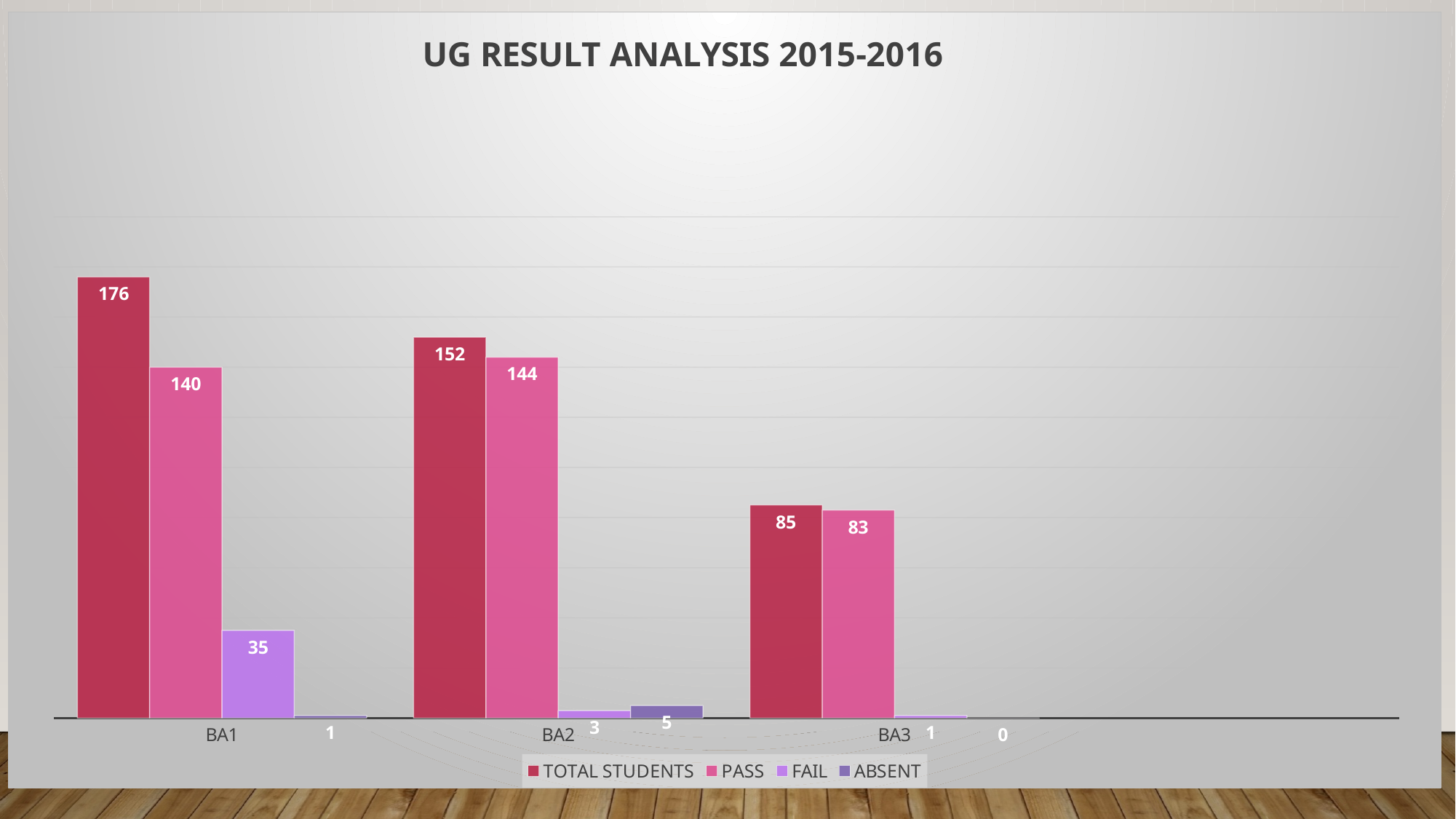
What kind of chart is shown on the slide? Bar chart What is the ABSENT value for BA2? 5 How many series does the legend list? 4 Which category has the highest TOTAL STUDENTS value? BA1 What is the title of the chart? UG RESULT ANALYSIS 2015-2016 What is the FAIL value for BA1? 35 Which category has the lowest PASS value? BA3 Which is larger, the FAIL value for BA1 or the FAIL value for BA2? BA1 What is the PASS value for BA2? 144 How many categories are shown on the x axis? 3 What is the value for TOTAL STUDENTS in BA1? 176 What is the difference between TOTAL STUDENTS and PASS for BA1? 36